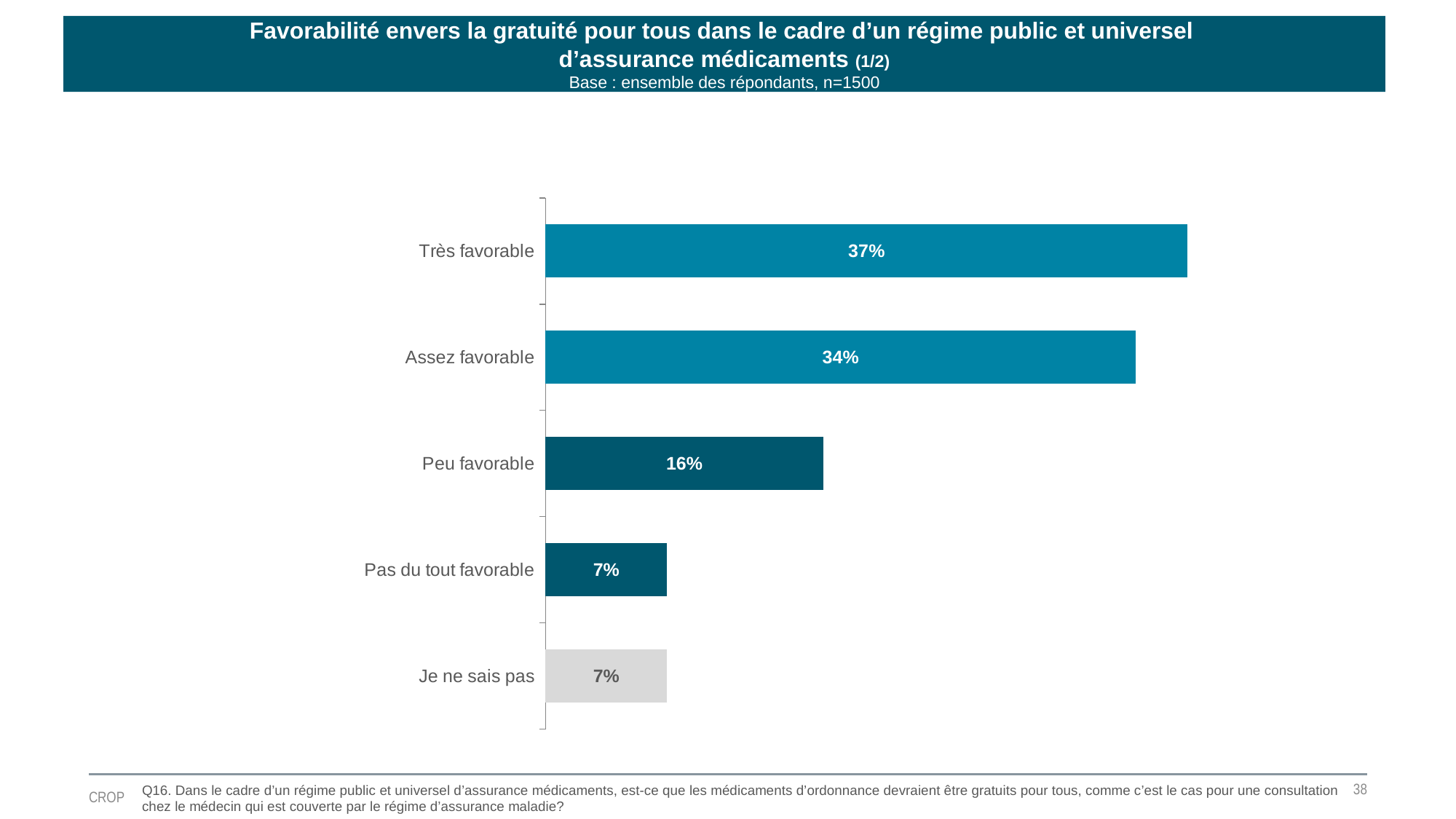
Which is larger, the value for "Peu favorable" or the value for "Pas du tout favorable"? Peu favorable What is the base (number of respondents) stated under the chart title? n=1500 What is the value for "Peu favorable"? 16% What is the value for "Je ne sais pas"? 7% What kind of chart is shown on the slide? Bar chart What is the value for "Pas du tout favorable"? 7% What is the difference between the values for "Très favorable" and "Assez favorable"? 3% What is the difference between the values for "Assez favorable" and "Peu favorable"? 18% What is the value for "Très favorable"? 37% How many categories are shown in the chart? 5 What is the value for "Assez favorable"? 34% Which category has the highest value? Très favorable